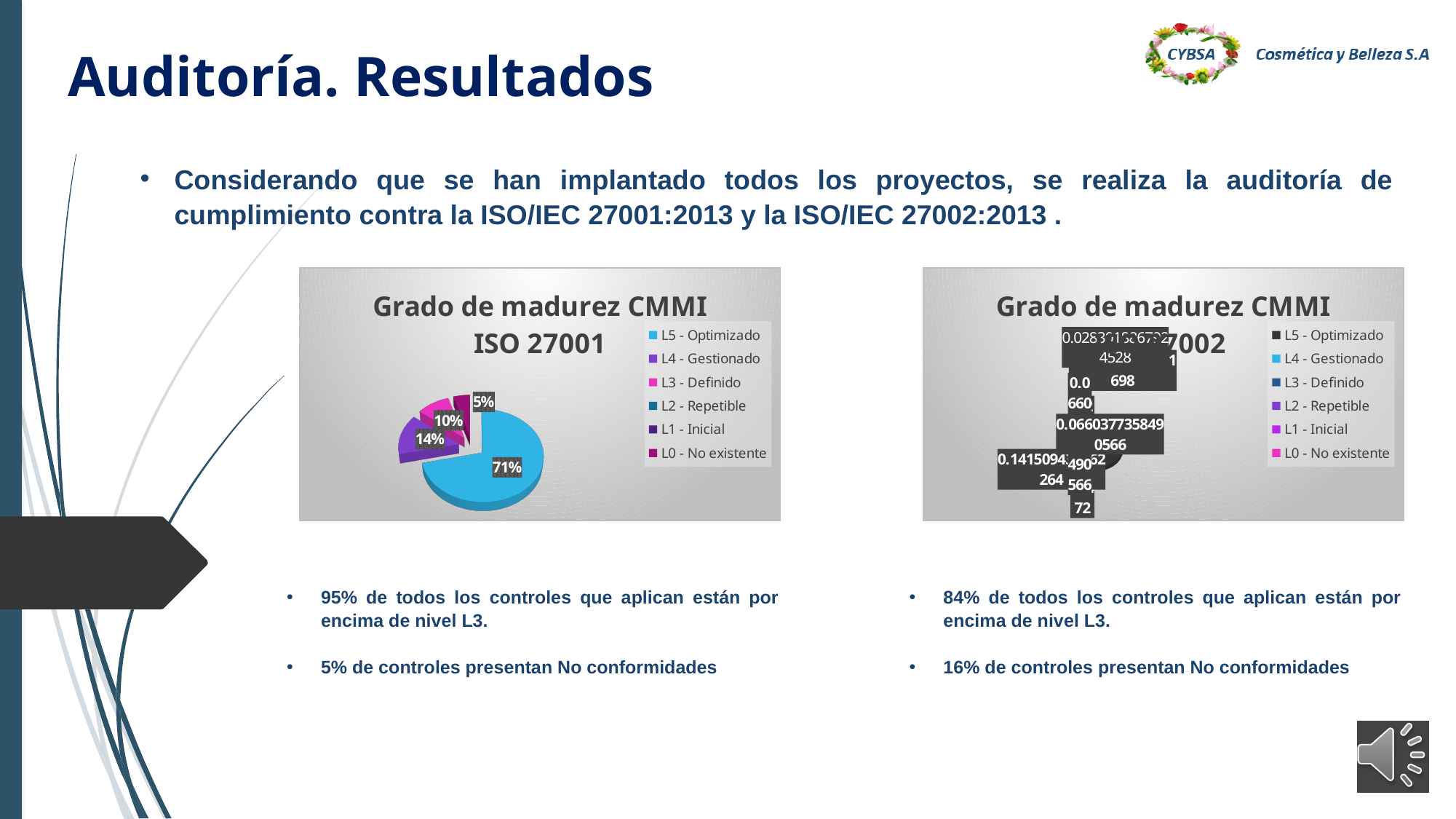
In the left chart 'Grado de madurez CMMI ISO 27001', which is larger, L4 - Gestionado or L3 - Definido? L4 - Gestionado How many entries does the legend of the left chart 'Grado de madurez CMMI ISO 27001' list? 6 How many entries does the legend of the right chart 'Grado de madurez CMMI ISO 27002' list? 6 In the left chart 'Grado de madurez CMMI ISO 27001', how many percentage points larger is L5 - Optimizado than L4 - Gestionado? 57 percentage points In the left chart 'Grado de madurez CMMI ISO 27001', what share is shown for L3 - Definido? 10% In the left chart 'Grado de madurez CMMI ISO 27001', what share is shown for L4 - Gestionado? 14% What is the first legend entry of the right chart 'Grado de madurez CMMI ISO 27002'? L5 - Optimizado In the left chart 'Grado de madurez CMMI ISO 27001', what is the smallest percentage labelled on the pie? 5% In the left chart 'Grado de madurez CMMI ISO 27001', what share is shown for L5 - Optimizado? 71% How many percentage labels are shown on the pie in the left chart 'Grado de madurez CMMI ISO 27001'? 4 In the left chart 'Grado de madurez CMMI ISO 27001', which level has the largest slice? L5 - Optimizado What kind of chart is the left chart titled 'Grado de madurez CMMI ISO 27001'? pie chart